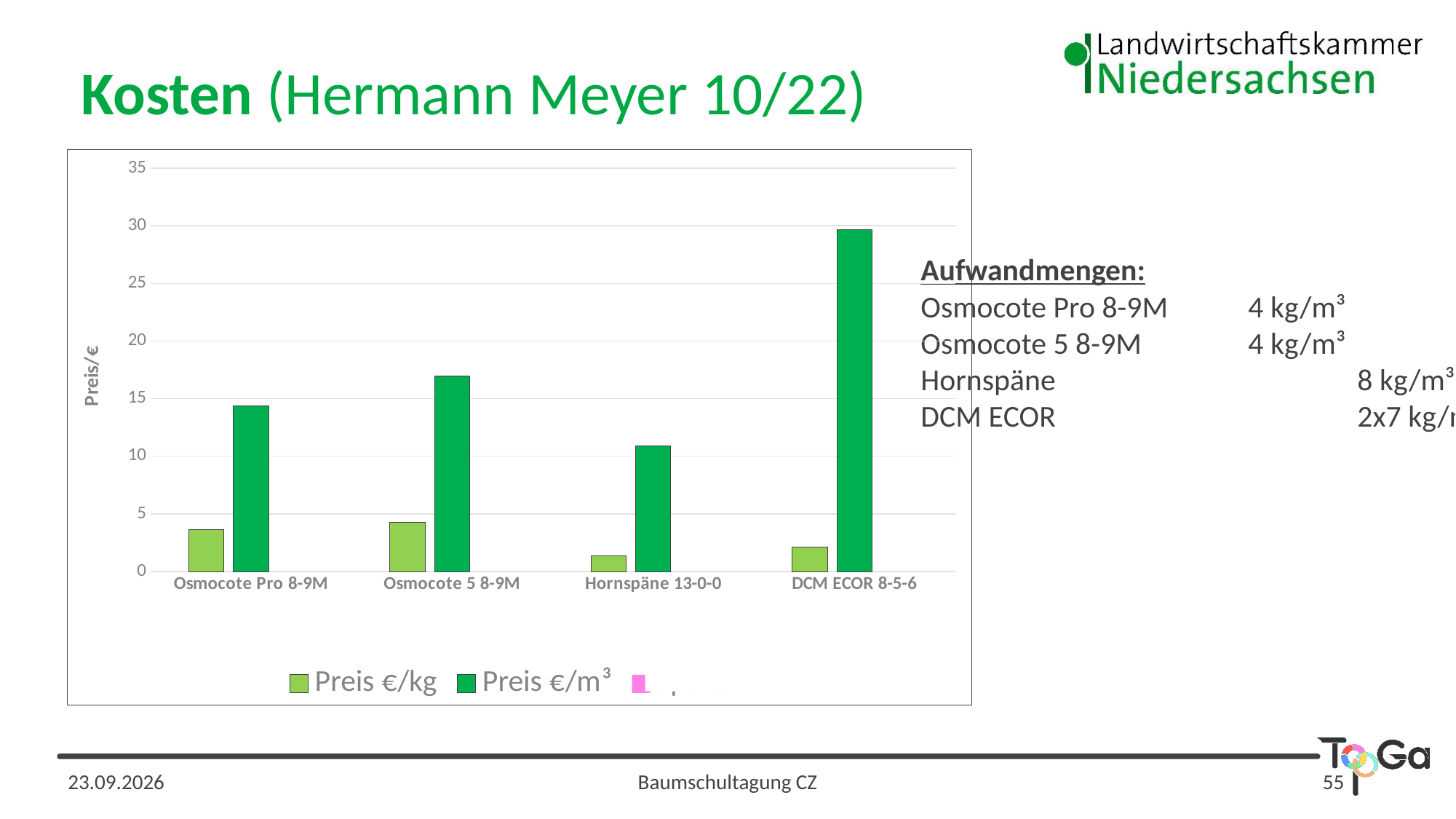
Is the Preis €/kg value for Osmocote Pro 8-9M greater or less than 5? less Is the Preis €/m³ value for DCM ECOR 8-5-6 greater or less than 25? greater Which category has the highest Preis €/m³ value? DCM ECOR 8-5-6 What kind of chart is shown on the slide? bar chart Which category has the lowest Preis €/kg value? Hornspäne 13-0-0 Is the Preis €/m³ value for Hornspäne 13-0-0 greater or less than 15? less How many fertiliser categories are shown on the x axis of the chart? 4 Which category has the lowest Preis €/m³ value? Hornspäne 13-0-0 Which is larger, the Preis €/m³ value for Osmocote 5 8-9M or for Osmocote Pro 8-9M? Osmocote 5 8-9M What is the label of the vertical axis of the chart? Preis/€ Which is larger, the Preis €/kg value for DCM ECOR 8-5-6 or for Hornspäne 13-0-0? DCM ECOR 8-5-6